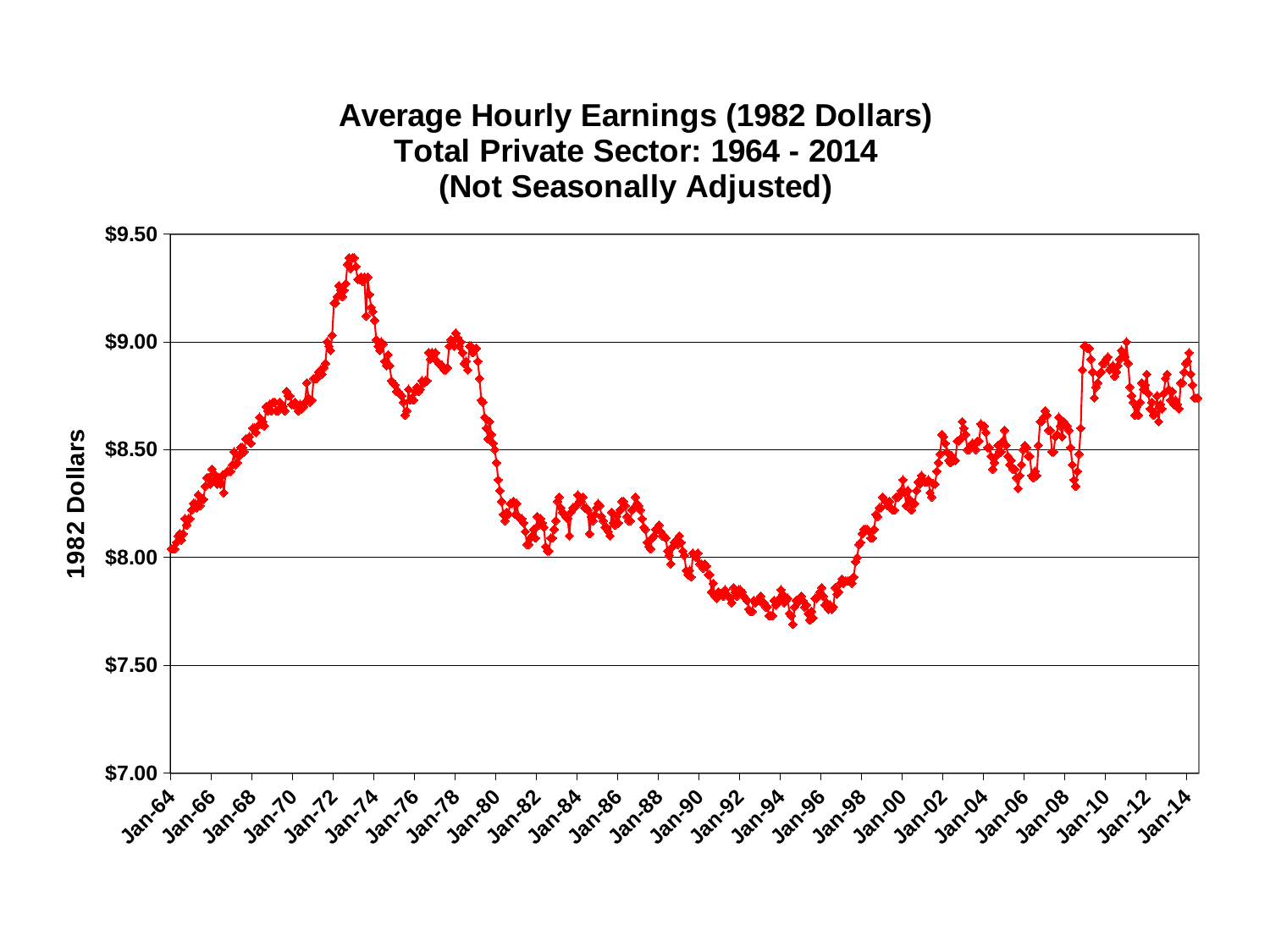
Is the peak value reached around 1973 greater or less than $9.00? greater Do the values rise or fall between Jan-64 and Jan-72? rise Is the value at Jan-94 greater or less than $8.00? less What is the title of the chart? Average Hourly Earnings (1982 Dollars) Total Private Sector: 1964 - 2014 (Not Seasonally Adjusted) Around which year does the series reach its lowest value? 1994 What kind of chart is shown on the slide? line chart Is the value at Jan-86 greater or less than $8.50? less Around which year does the series reach its highest value? 1973 What is the label on the vertical axis? 1982 Dollars Do the values rise or fall between Jan-80 and Jan-94? fall